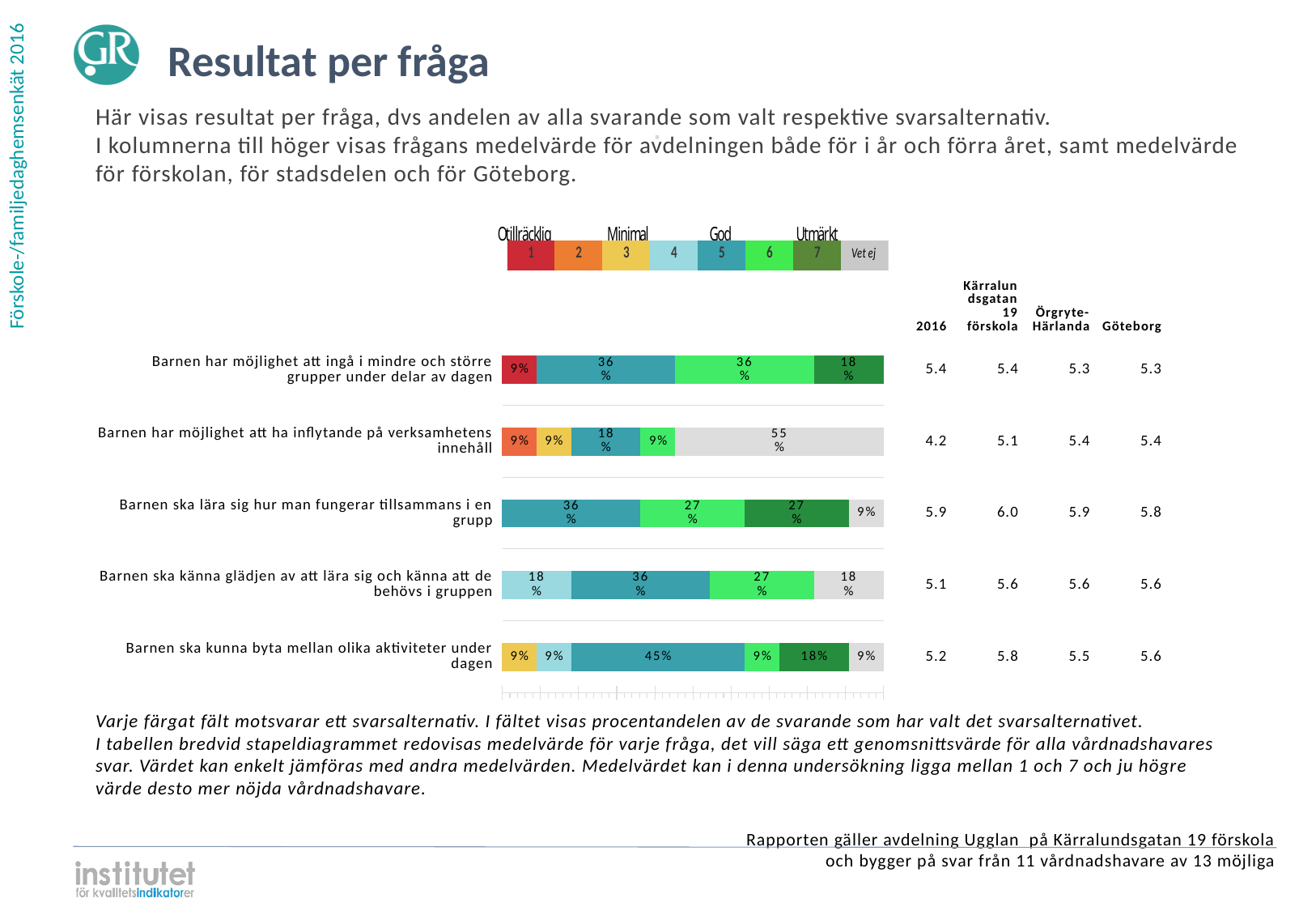
Which question has the lowest 2016 mean value in the table? Barnen har möjlighet att ha inflytande på verksamhetens innehåll What is the largest segment in the bar for 'Barnen ska kunna byta mellan olika aktiviteter under dagen'? 45% What percentage of respondents answered 'Vet ej' for 'Barnen har möjlighet att ha inflytande på verksamhetens innehåll'? 55% What is the difference between the Kärralundsgatan 19 förskola mean and the 2016 mean for 'Barnen ska kunna byta mellan olika aktiviteter under dagen'? 0.6 For 'Barnen ska känna glädjen av att lära sig och känna att de behövs i gruppen', which is larger: the share answering 5 or the share answering 6? 5 (36%) How many answer options does the legend above the chart list? 8 What kind of chart is shown on the slide? Stacked bar chart What colour represents answer option 1 (Otillräcklig) in the legend? Red What is the 2016 mean value for 'Barnen ska lära sig hur man fungerar tillsammans i en grupp'? 5.9 Which question has the largest 'Vet ej' share? Barnen har möjlighet att ha inflytande på verksamhetens innehåll How many questions (categories) are plotted in the bar chart? 5 What percentage chose answer 7 (Utmärkt) for 'Barnen har möjlighet att ingå i mindre och större grupper under delar av dagen'? 18%